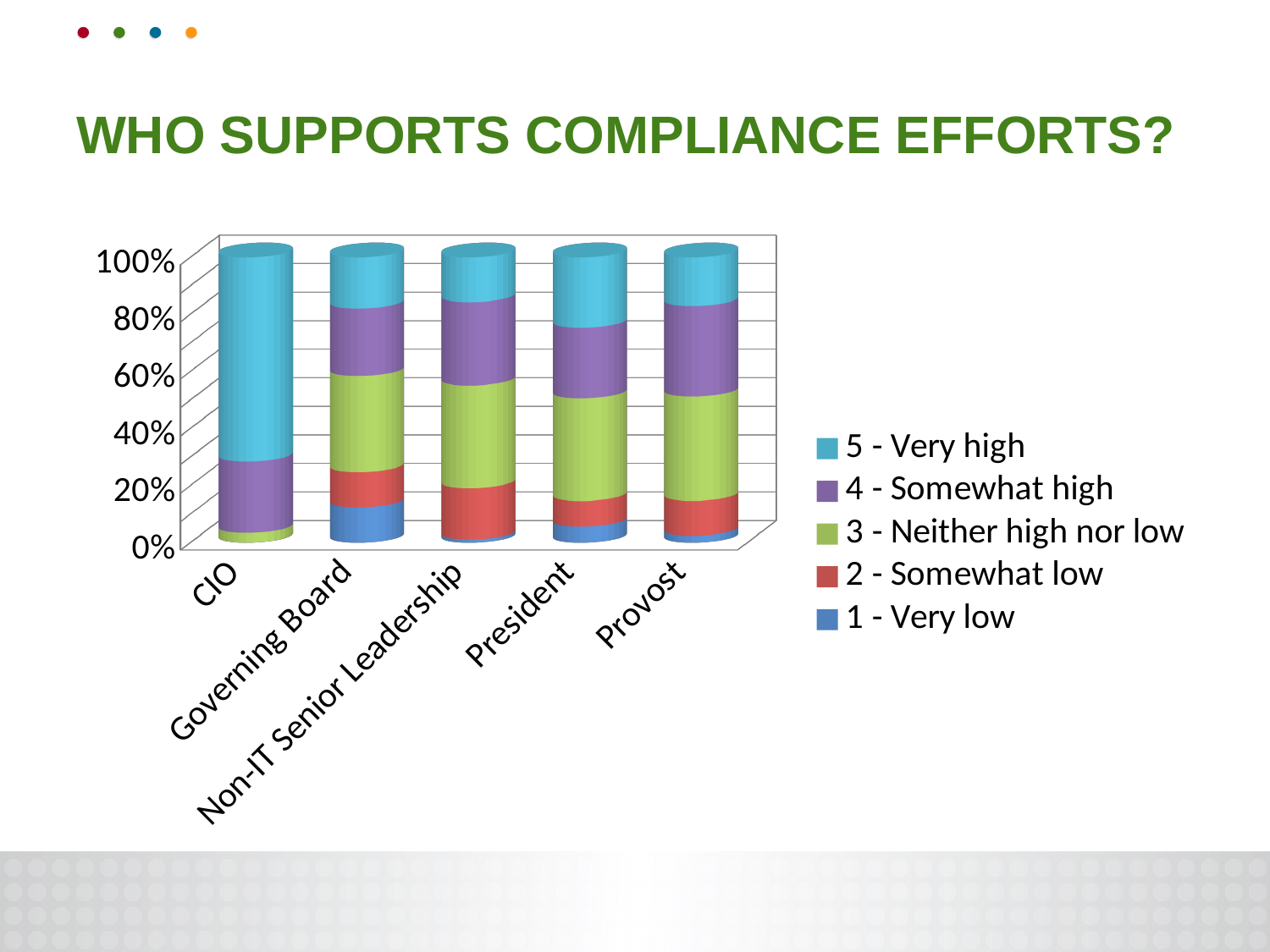
How many series does the chart legend list? 5 Is the '5 - Very high' share for Non-IT Senior Leadership greater or less than 40%? less Which category has the largest share of '5 - Very high' responses? CIO What is the title of the slide containing the chart? WHO SUPPORTS COMPLIANCE EFFORTS? Is the '1 - Very low' share for Governing Board greater or less than 20%? less What kind of chart is shown on the slide? Stacked bar chart Is the '5 - Very high' share for CIO greater or less than 60%? greater How many categories are shown on the x axis of the chart? 5 Which category has the largest share of '1 - Very low' responses? Governing Board Which is larger: the '5 - Very high' share for CIO or for President? CIO What does each stacked bar in the chart total? 100%